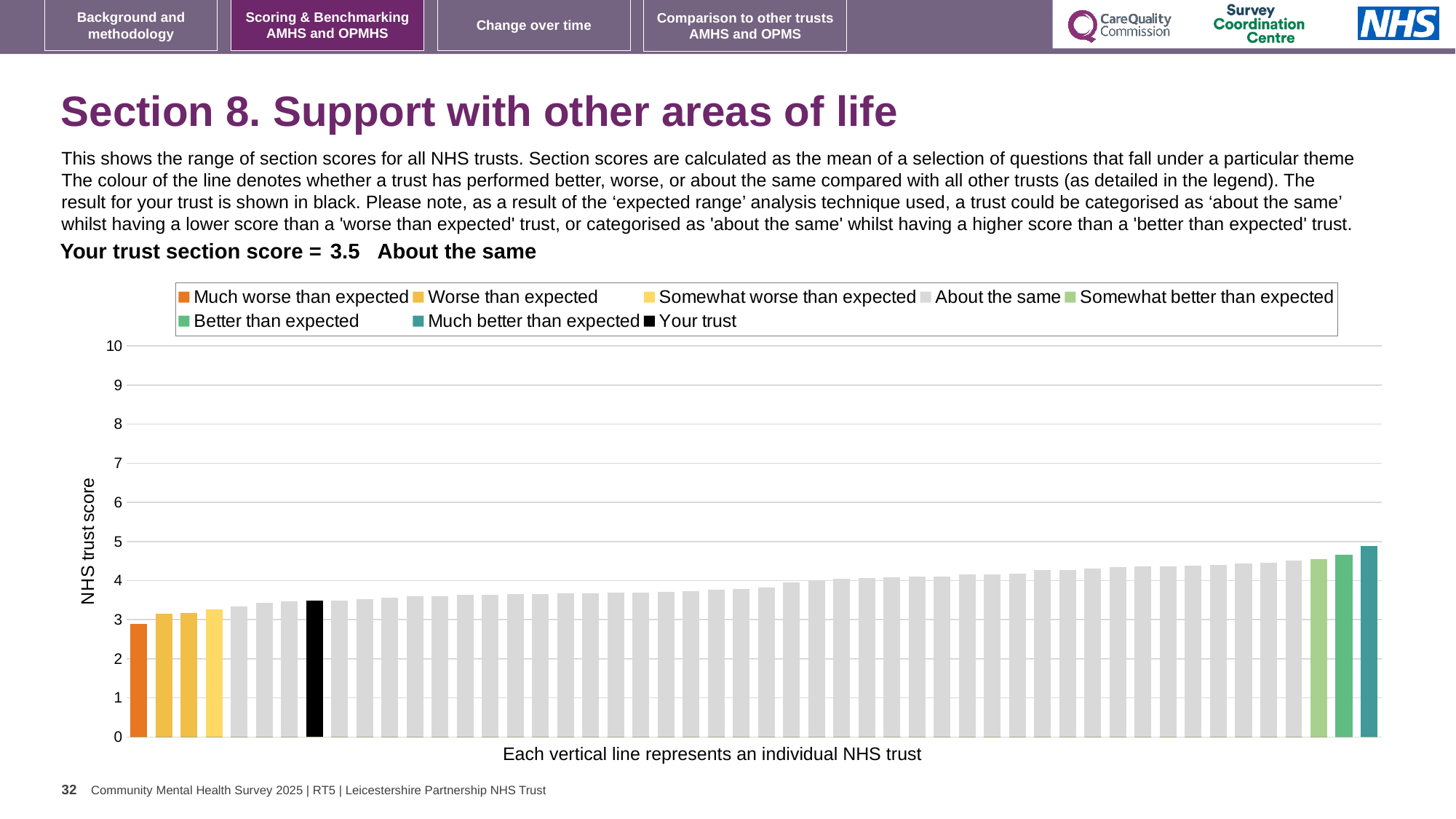
Is the value for your trust (the black bar) greater or less than 4? less Do the bar values rise or fall from left to right along the x axis? rise Which legend category does the highest bar on the chart belong to? Much better than expected Which category does your trust fall into according to the slide? About the same What kind of chart is shown on the slide? bar chart How many entries does the chart legend list? 8 Is the value of the tallest bar (Much better than expected) greater or less than 4? greater Is the value of the shortest bar (Much worse than expected) greater or less than 2? greater Which legend category does the lowest bar on the chart belong to? Much worse than expected What is the section score for your trust shown on the slide? 3.5 What is the label on the vertical axis of the chart? NHS trust score